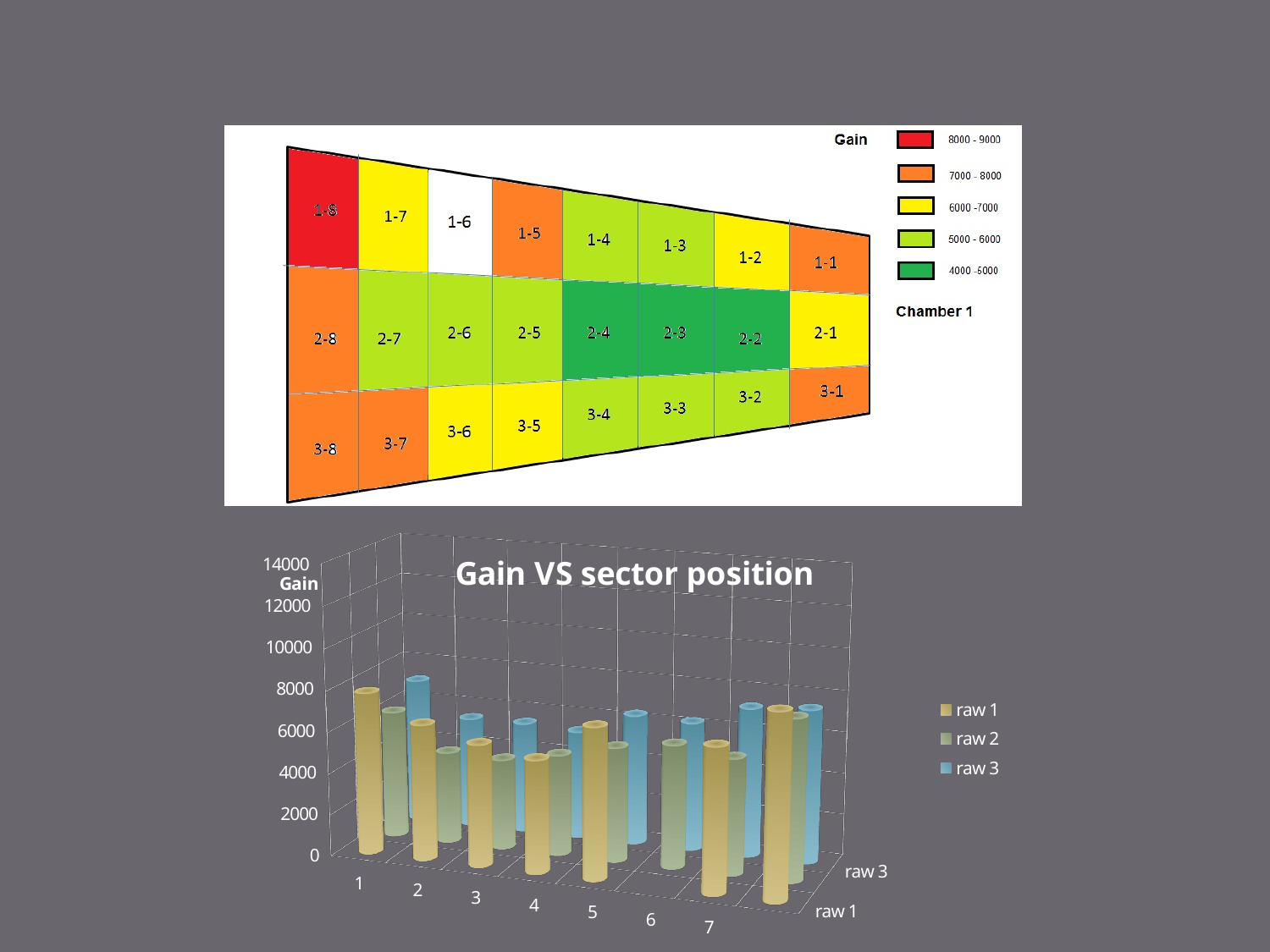
In the top heat map chart, how many gain ranges does the legend list? 5 What is the title of the bottom chart? Gain VS sector position In the top heat map chart, how many sectors are coloured dark green (4000 - 5000 range)? 3 In the top heat map chart, which gain range does sector 2-1 fall into according to its colour? 6000 - 7000 In the bottom chart 'Gain VS sector position', is the value for raw 3 at position 1 greater or less than 6000? greater In the bottom chart 'Gain VS sector position', is the value for raw 2 at position 3 greater or less than 8000? less How many series does the legend of the bottom chart 'Gain VS sector position' list? 3 In the bottom chart 'Gain VS sector position', is the value for raw 1 at position 4 greater or less than 6000? less In the bottom chart 'Gain VS sector position', what is the label on the vertical axis? Gain What kind of chart is the bottom chart titled 'Gain VS sector position'? bar chart In the top heat map chart, which sector is coloured red, corresponding to the 8000 - 9000 gain range? 1-8